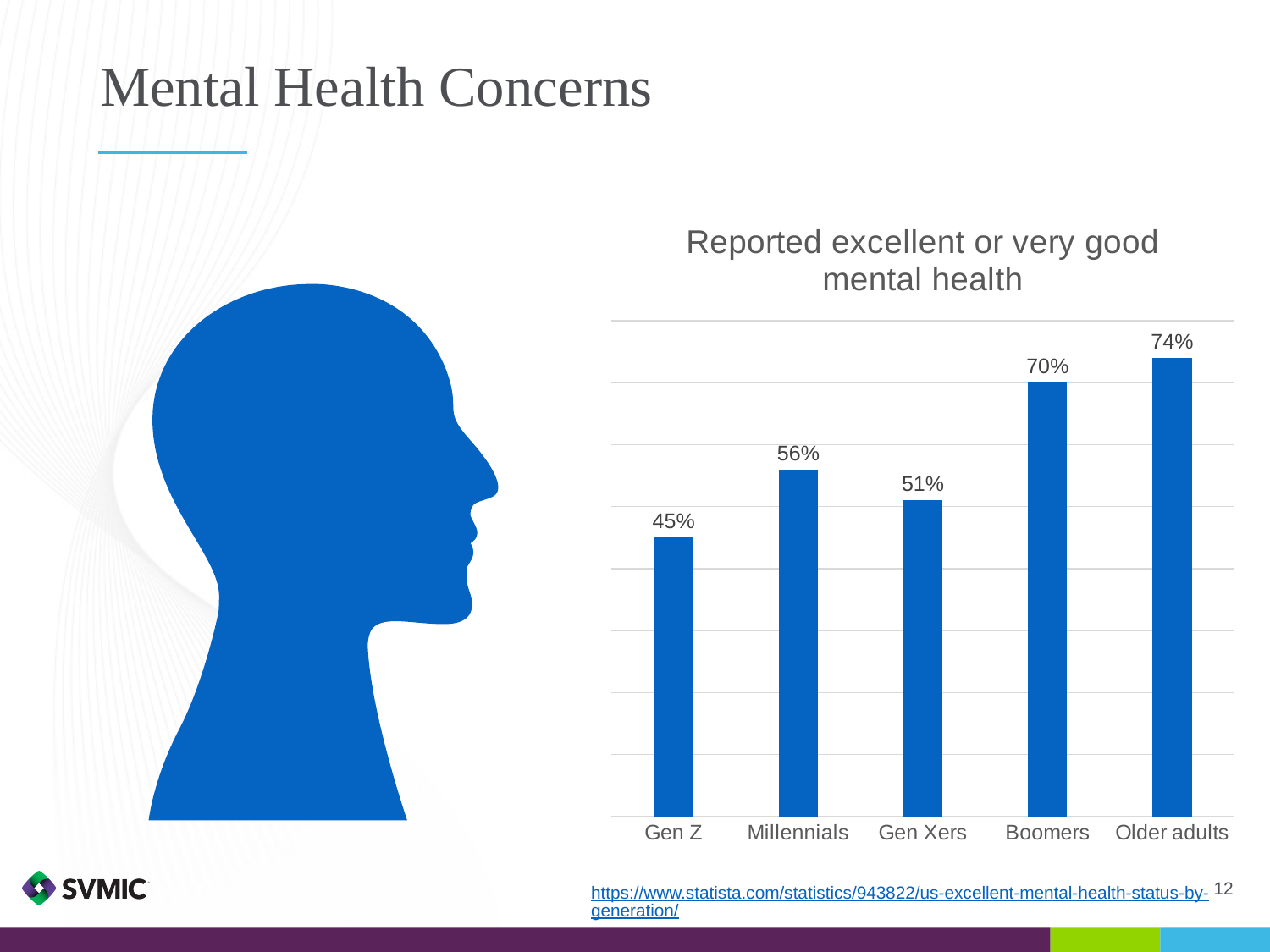
Which generation has the lowest share reporting excellent or very good mental health? Gen Z What is the value shown for Gen Xers? 51% Which generation has the highest share reporting excellent or very good mental health? Older adults What is the difference between the values for Older adults and Gen Z? 29% How many generations are shown on the x axis of the chart? 5 What is the value shown for Boomers? 70% Is the value for Boomers greater or less than the value for Millennials? greater Which is larger, the value for Millennials or the value for Gen Xers? Millennials What kind of chart is shown on the slide? Bar chart What is the difference between the values for Millennials and Gen Xers? 5% What is the title of the chart? Reported excellent or very good mental health What percentage of Gen Z reported excellent or very good mental health? 45%